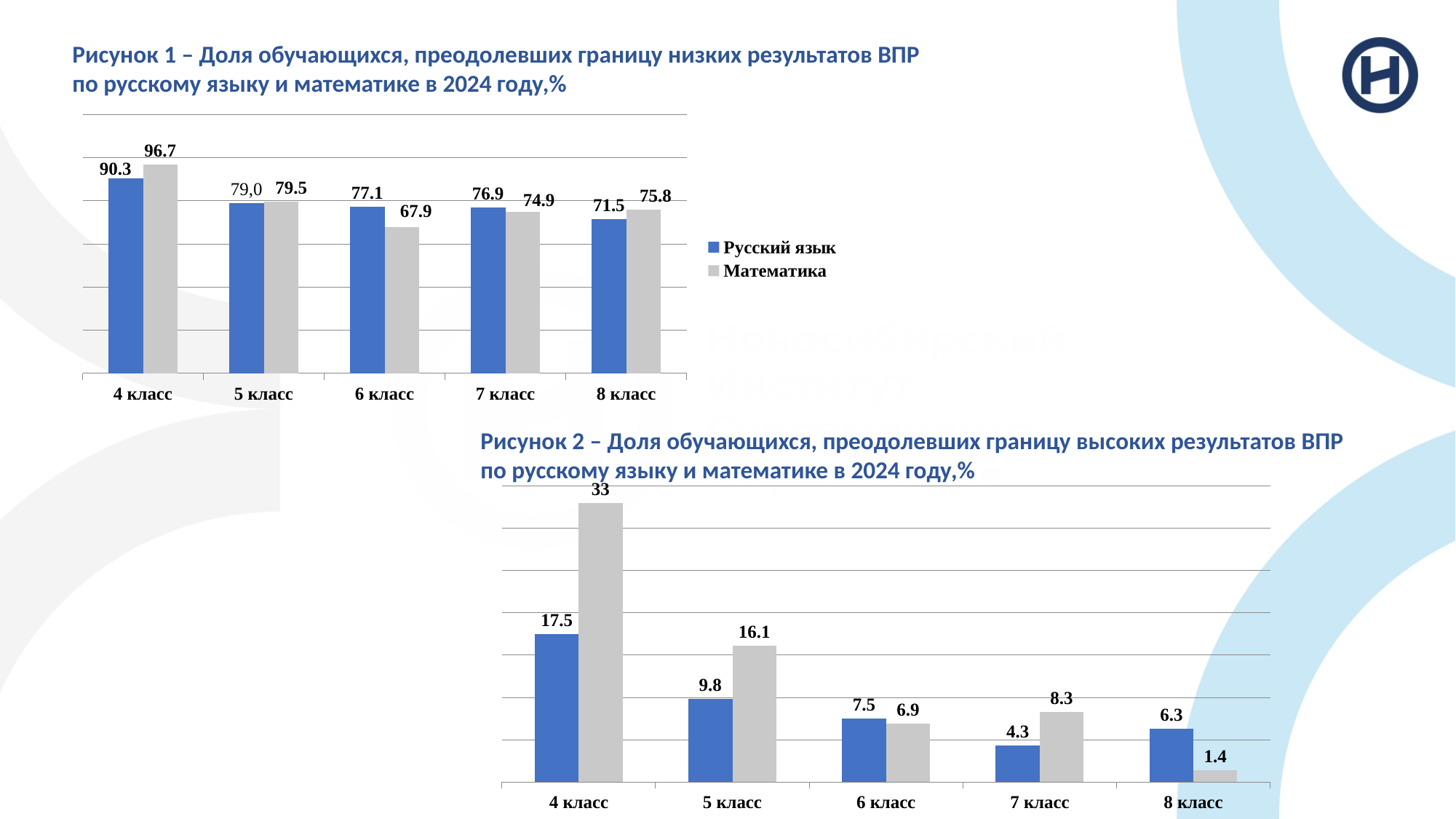
In the top chart (Рисунок 1), which class has the lowest value for Русский язык? 8 класс How many series does the legend of the top chart (Рисунок 1) list? 2 In the top chart (Рисунок 1), what is the difference between Математика and Русский язык in 4 класс? 6.4 What type of chart is the bottom chart (Рисунок 2)? Bar chart In the top chart (Рисунок 1), what is the value for Математика in 6 класс? 67.9 In the bottom chart (Рисунок 2), which class has the lowest value for Математика? 8 класс In the top chart (Рисунок 1), which is larger in 7 класс: Русский язык or Математика? Русский язык In the bottom chart (Рисунок 2), what is the value for Русский язык in 7 класс? 4.3 In the bottom chart (Рисунок 2), what is the difference between Математика and Русский язык in 5 класс? 6.3 In the top chart (Рисунок 1), what is the value for Русский язык in 4 класс? 90.3 In the top chart (Рисунок 1), which class has the highest value for Математика? 4 класс In the bottom chart (Рисунок 2), what is the value for Математика in 4 класс? 33